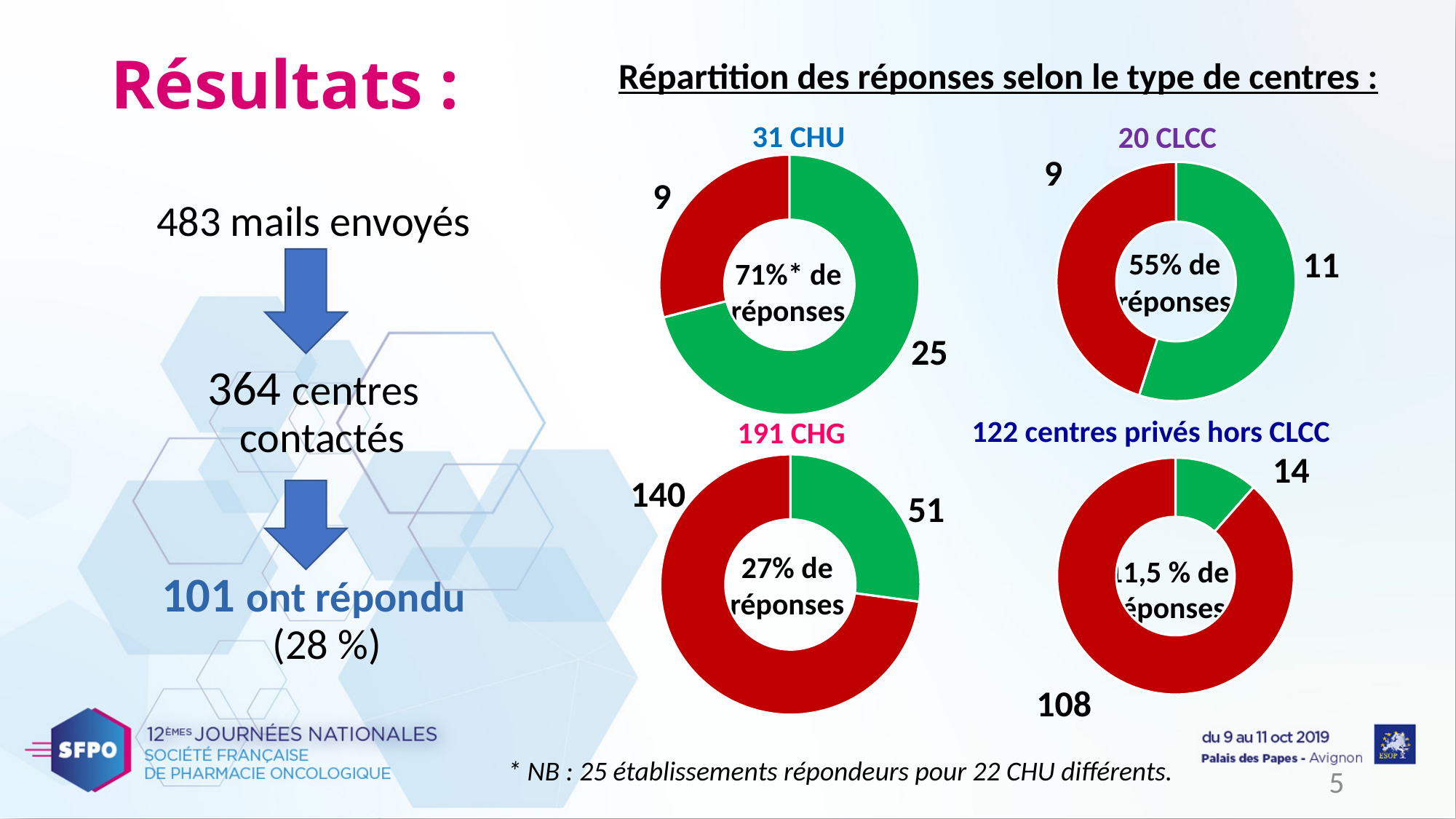
In the '20 CLCC' chart, what is the value of the green segment? 11 In the '191 CHG' chart, what is the value of the red segment? 140 In the '122 centres privés hors CLCC' chart, what is the value of the green segment? 14 What is the title above the four donut charts? Répartition des réponses selon le type de centres : In the '122 centres privés hors CLCC' chart, which segment is larger, the red one or the green one? Red In the '191 CHG' chart, what is the difference between the red segment and the green segment? 89 What response rate is printed in the centre of the '191 CHG' chart? 27% de réponses What kind of chart is used for the '31 CHU' chart? Pie (donut) chart How many donut charts are shown on the slide? 4 In the '20 CLCC' chart, what is the difference between the green segment (11) and the red segment (9)? 2 In the '31 CHU' chart, what is the value of the red segment? 9 In the '31 CHU' chart, what is the value of the green segment? 25